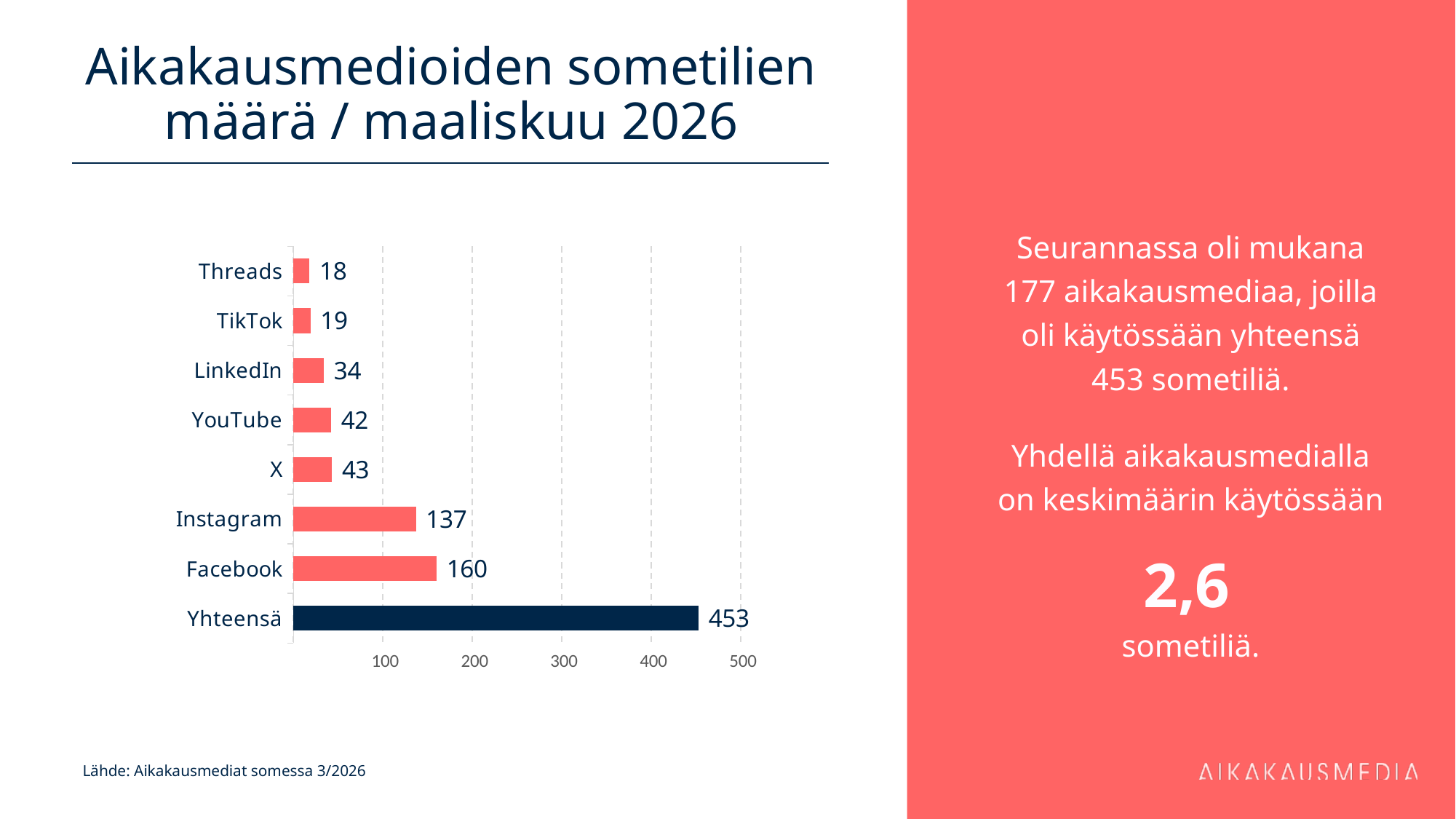
Which platform has the lowest value? Threads What is the value for Instagram? 137 Which bar is shown in a different (dark navy) colour from the others? Yhteensä What is the value for LinkedIn? 34 What is the value shown for Yhteensä? 453 What is the difference between the values for Facebook and Instagram? 23 What kind of chart is shown on the slide? Bar chart How many bars are shown in the chart? 8 Is the value for Instagram greater or less than 100? greater Which has a larger value, YouTube or LinkedIn? YouTube What is the value for Facebook? 160 Excluding the Yhteensä total bar, which platform has the highest value? Facebook